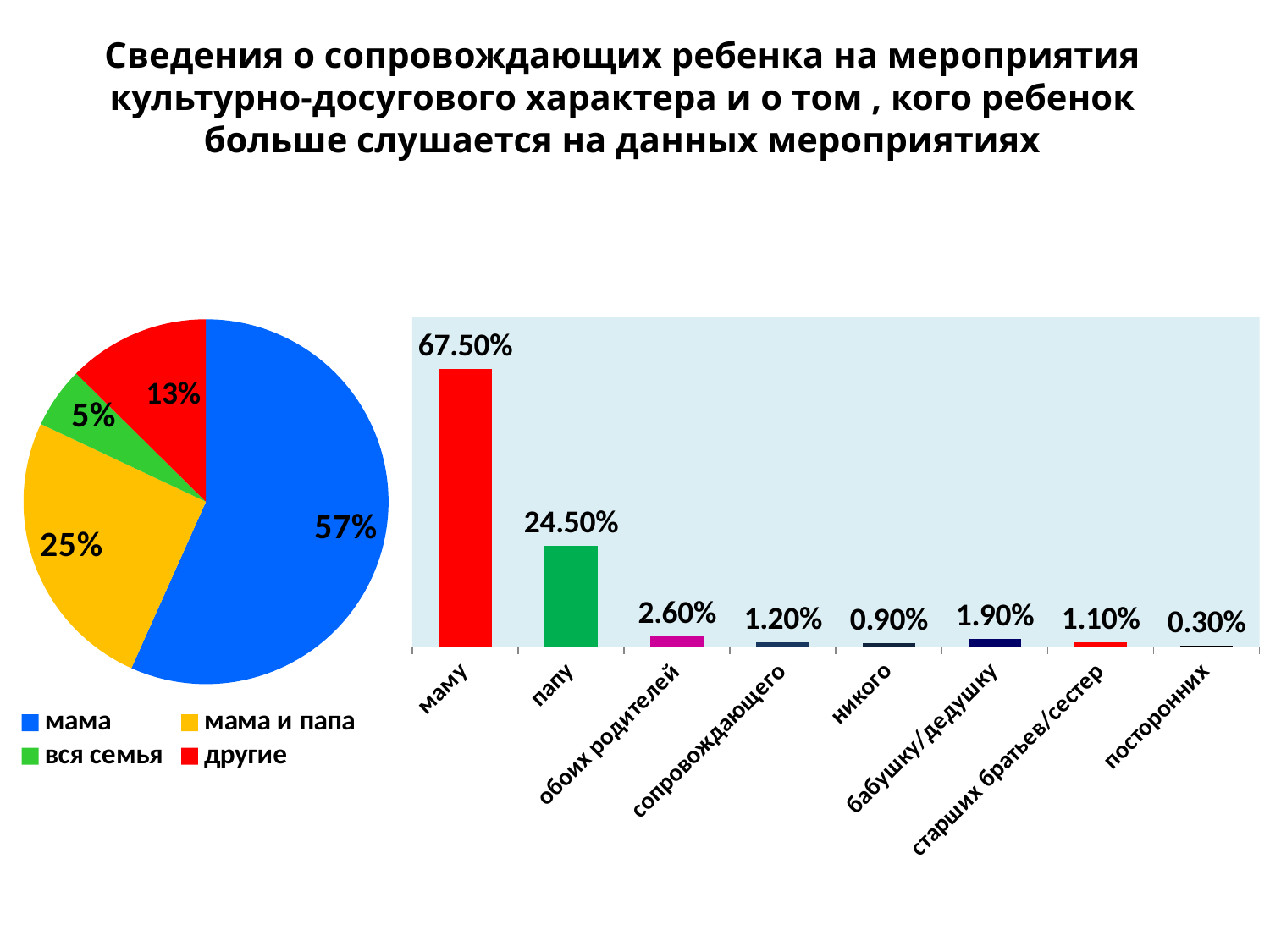
In the pie chart on the left, how many entries does the legend list? 4 In the bar chart on the right, which category has the lowest value? посторонних In the pie chart on the left, what is the value for "мама и папа"? 25% In the pie chart on the left, what share does the slice for "мама" have? 57% What kind of chart is shown on the right side of the slide? bar chart In the bar chart on the right, what is the difference between the values for "маму" and "папу"? 43.00% In the bar chart on the right, which is larger: the value for "бабушку/дедушку" or the value for "сопровождающего"? бабушку/дедушку In the bar chart on the right, what is the value for "папу"? 24.50% In the bar chart on the right, how many categories are shown on the x axis? 8 In the bar chart on the right, which category has the highest value? маму In the pie chart on the left, which category has the smallest slice? вся семья In the pie chart on the left, what is the difference between the values for "другие" and "вся семья"? 8%